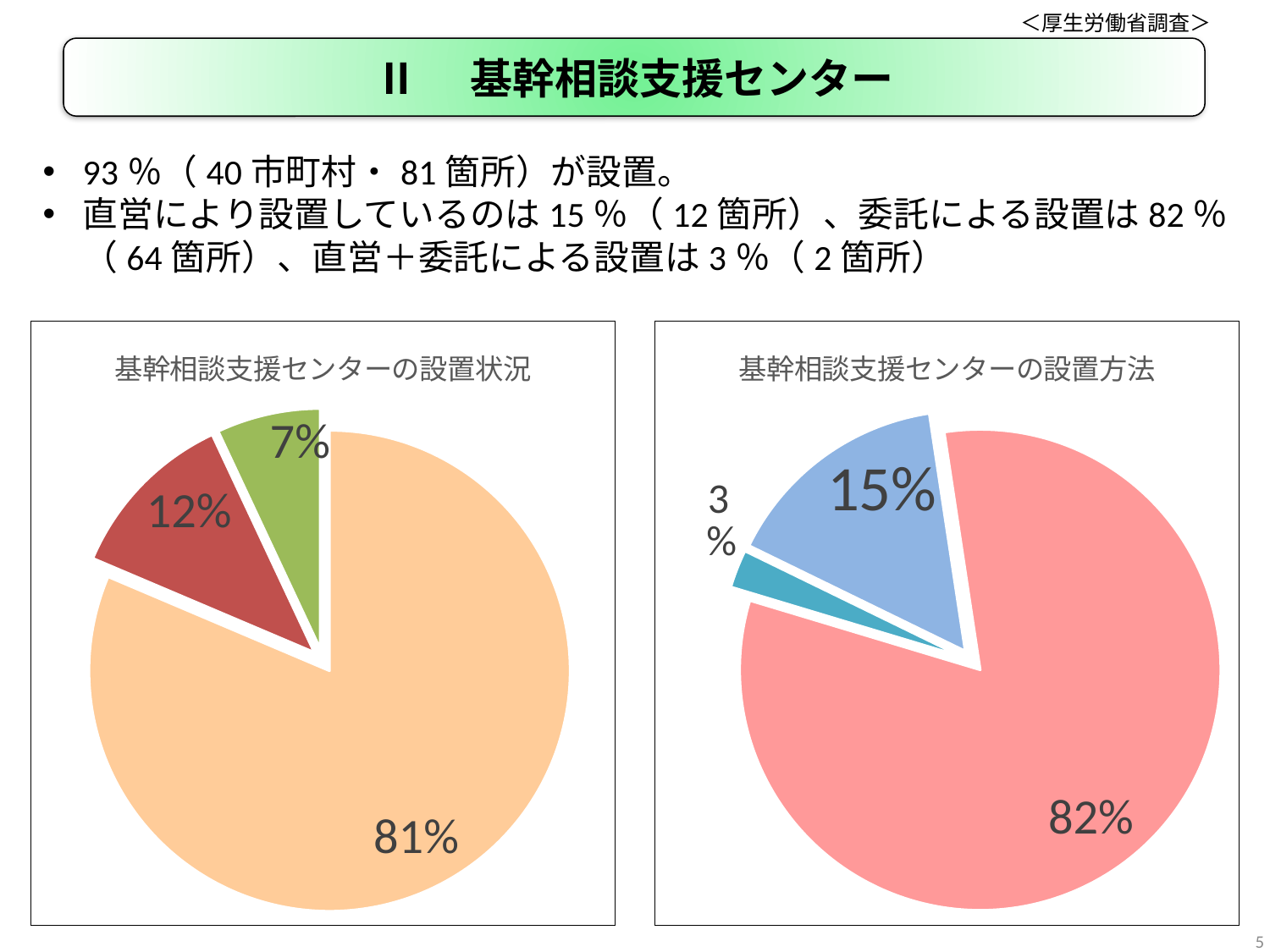
In the left chart (基幹相談支援センターの設置状況), what is the share of the red slice? 12% In the left chart (基幹相談支援センターの設置状況), what is the share of the largest slice? 81% In the right chart (基幹相談支援センターの設置方法), what is the share of the smallest slice? 3% In the left chart (基幹相談支援センターの設置状況), what is the share of the smallest slice? 7% What is the title of the right chart? 基幹相談支援センターの設置方法 In the right chart (基幹相談支援センターの設置方法), what is the share of the largest slice? 82% In the left chart (基幹相談支援センターの設置状況), which slice is larger, the red one or the green one? The red one (12%) In the right chart (基幹相談支援センターの設置方法), what is the difference between the largest slice (82%) and the light blue slice (15%)? 67 percentage points In the right chart (基幹相談支援センターの設置方法), what is the share of the light blue slice? 15% What kind of chart is the left chart titled 基幹相談支援センターの設置状況? Pie chart In the left chart (基幹相談支援センターの設置状況), what is the difference between the red slice (12%) and the green slice (7%)? 5 percentage points In the left chart (基幹相談支援センターの設置状況), how many slices does the pie have? 3